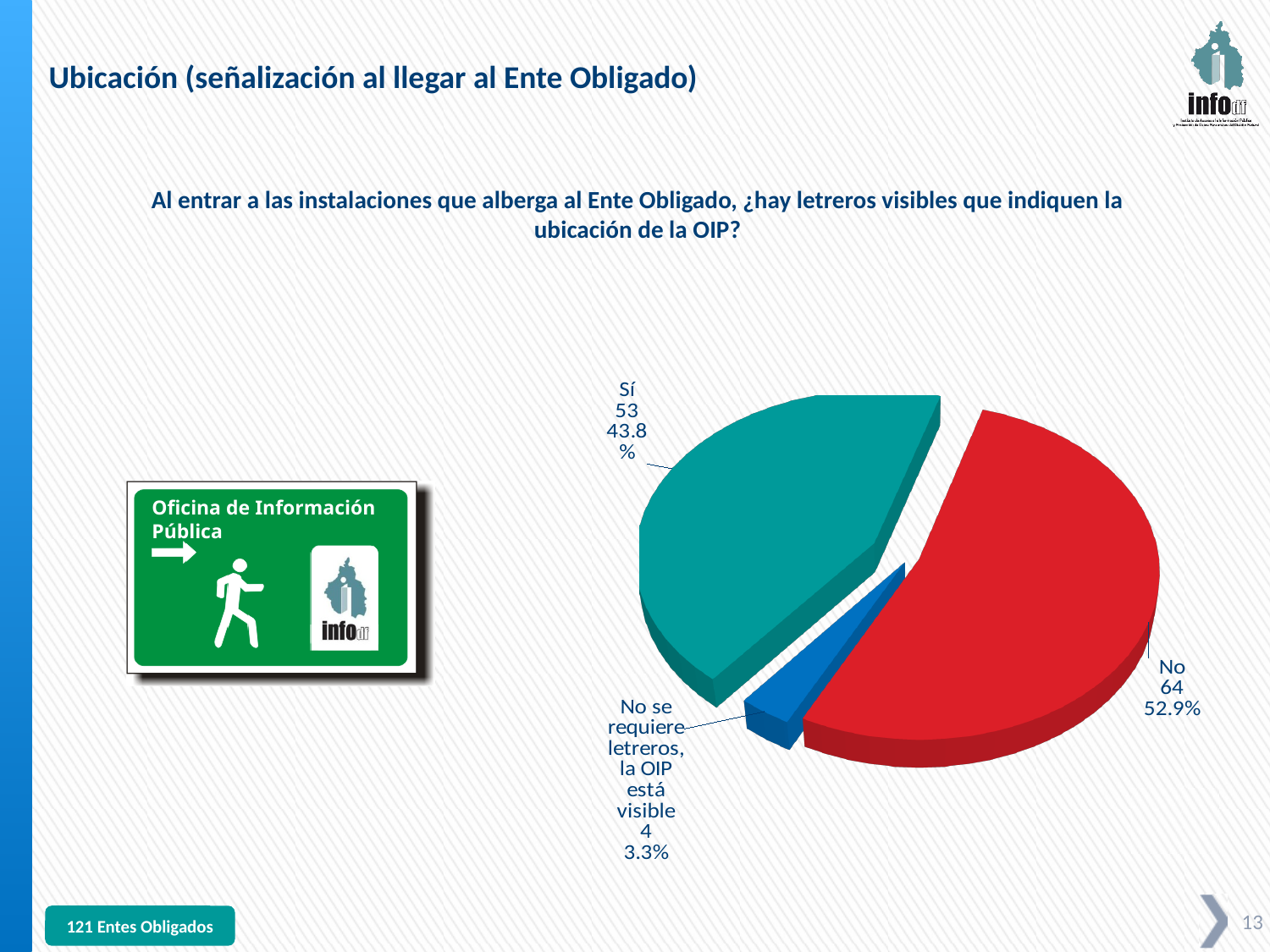
How many Entes Obligados answered "No"? 64 How many slices does the pie chart have? 3 What percentage of the pie corresponds to "Sí"? 43.8% Which category has the largest slice of the pie? No What percentage of the pie corresponds to "No"? 52.9% Which category has the smallest slice of the pie? No se requiere letreros, la OIP está visible Which is larger, the count for "Sí" or the count for "No se requiere letreros, la OIP está visible"? Sí How many Entes Obligados answered "Sí"? 53 What percentage of the pie corresponds to "No se requiere letreros, la OIP está visible"? 3.3% What colour is the "No" slice of the pie? red What is the difference in count between "No" and "Sí"? 11 What kind of chart is shown on the slide? pie chart